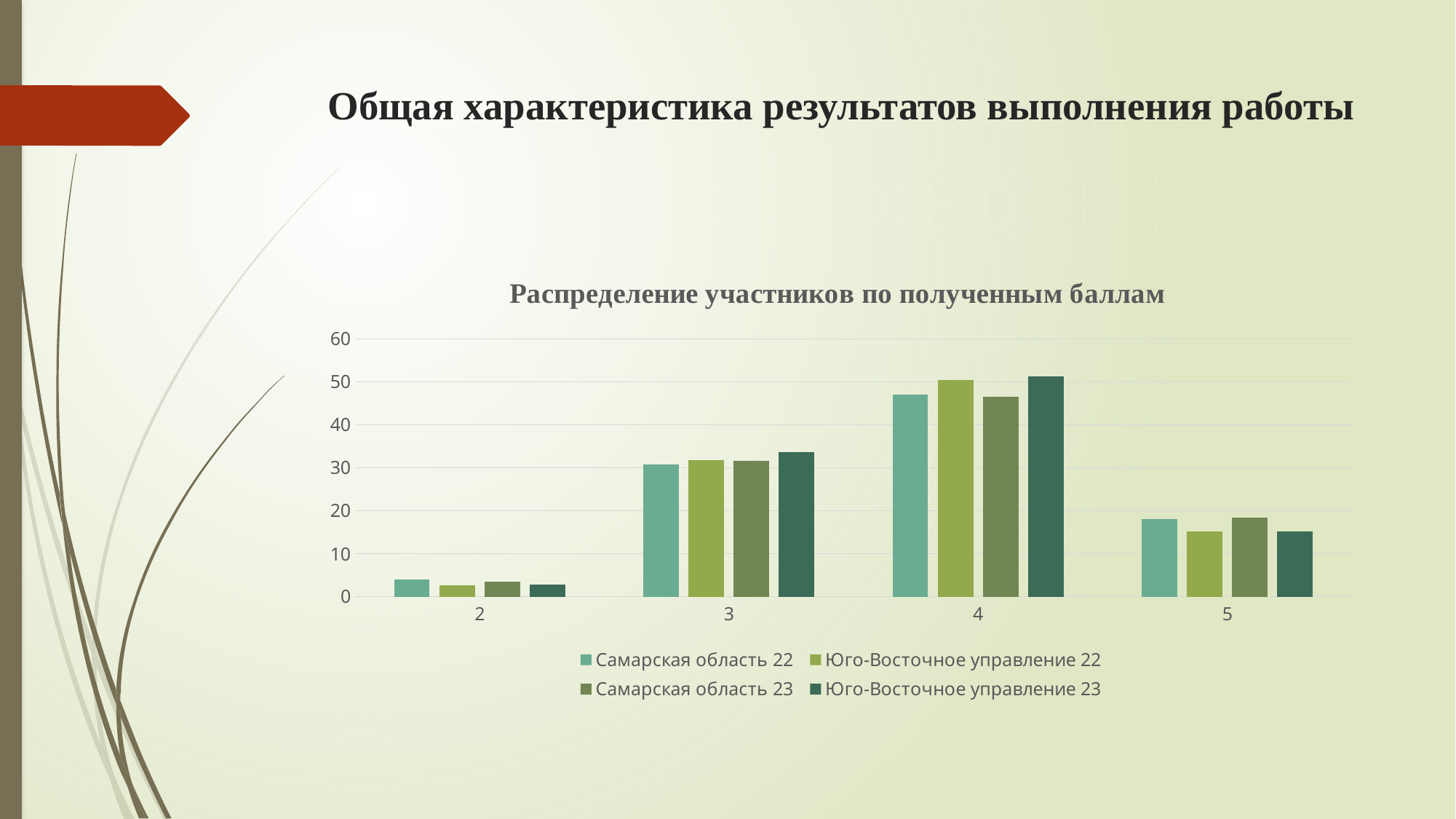
In category 4, which is larger: Юго-Восточное управление 23 or Самарская область 23? Юго-Восточное управление 23 How many categories are shown on the x axis? 4 What kind of chart is shown on the slide? bar chart For the series Юго-Восточное управление 23, which category has the lowest value? 2 In category 5, which is larger: Самарская область 22 or Юго-Восточное управление 22? Самарская область 22 Is the value for Юго-Восточное управление 22 in category 5 greater or less than 20? less How many series does the legend list? 4 For the series Самарская область 23, do the values rise or fall from category 4 to category 5? fall For the series Самарская область 22, which category has the highest value? 4 What is the title of the chart? Распределение участников по полученным баллам Is the value for Самарская область 22 in category 4 greater or less than 40? greater Is the value for Самарская область 23 in category 2 greater or less than 10? less